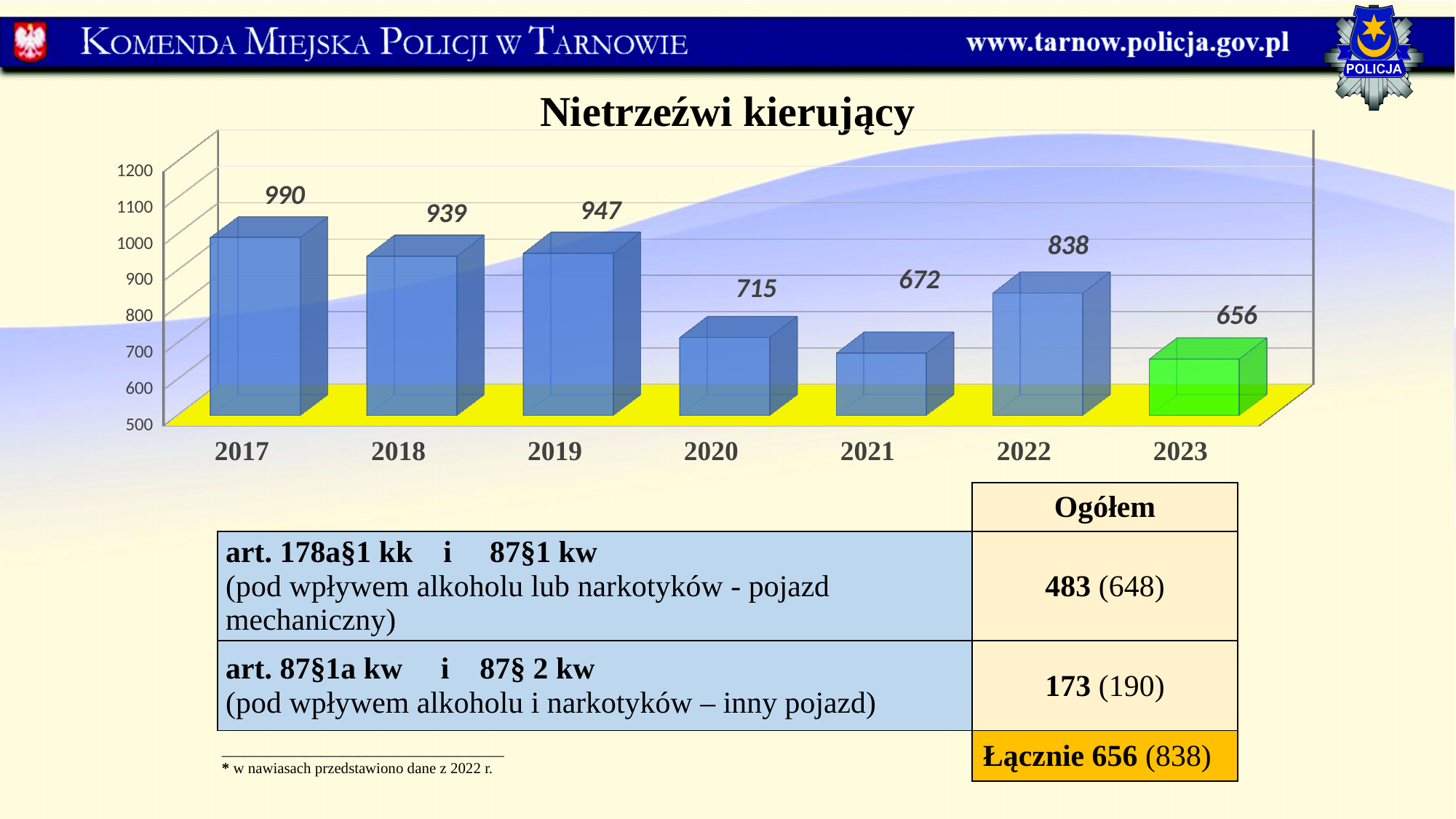
How many years are shown on the x axis? 7 Which is larger, the value for 2018 or the value for 2019? 2019 What is the value for 2017? 990 What is the difference between the values for 2022 and 2023? 182 What is the title of the chart? Nietrzeźwi kierujący What kind of chart is shown on the slide? bar chart What is the value for 2023? 656 Is the value for 2022 greater or less than 800? greater Which year has the highest value? 2017 Which year has the lowest value? 2023 What is the value for 2020? 715 What is the difference between the values for 2017 and 2021? 318